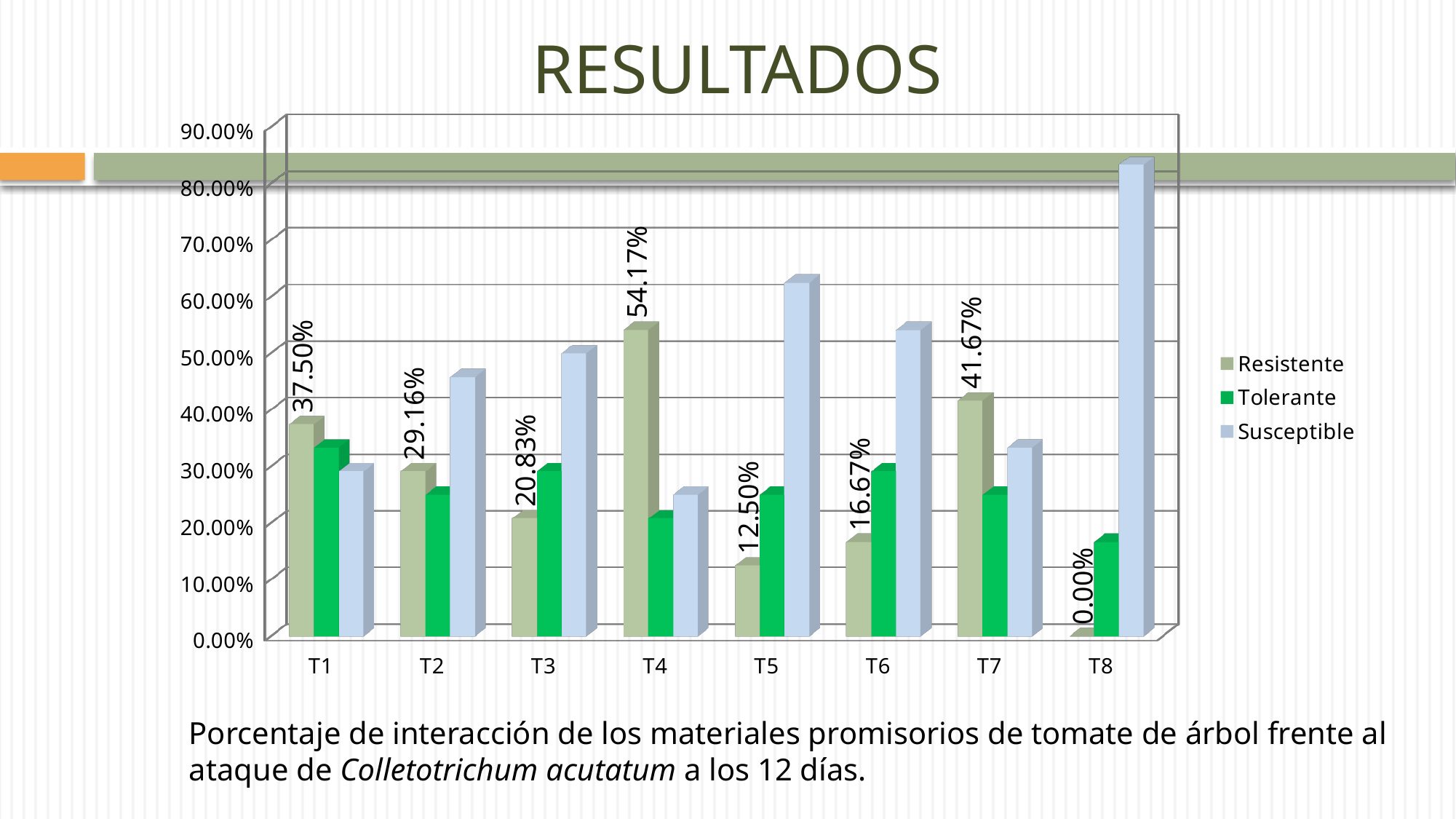
What is the Resistente value for T4? 54.17% Which category has the lowest Resistente value? T8 What is the Resistente value for T2? 29.16% Is the Susceptible value for T8 greater or less than 80.00%? greater How many series does the legend list? 3 Is the Tolerante value for T8 greater or less than 20.00%? less What is the difference between the Resistente values for T7 and T6? 25.00% Which category has the highest Resistente value? T4 How many categories are shown on the x axis? 8 What is the difference between the Resistente values for T4 and T1? 16.67% What is the Resistente value for T8? 0.00% Which has a larger Resistente value, T7 or T2? T7